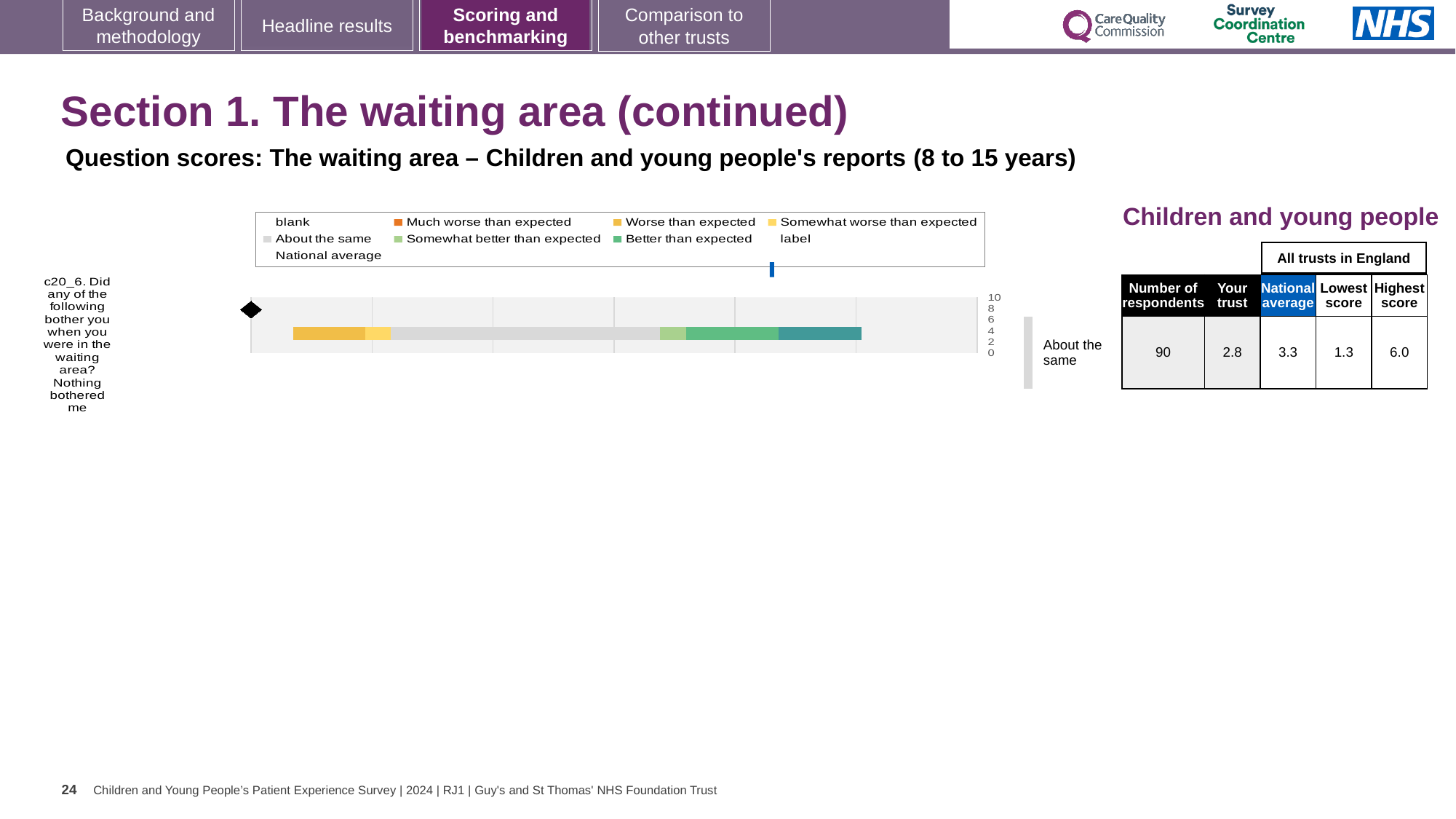
How many respondents answered question c20_6? 90 What kind of chart is shown on the slide? bar chart Which is larger, the 'Your trust' score or the national average? National average What is the difference between the national average and the 'Your trust' score? 0.5 What is the national average score shown in the table? 3.3 What is the highest score across all trusts in England shown in the table? 6.0 Which legend entry is shown with a dark orange colour? Much worse than expected What is the lowest score across all trusts in England shown in the table? 1.3 How many questions (categories) are plotted in the chart? 1 What is the difference between the highest score and the lowest score across all trusts in England? 4.7 What is the benchmark category shown to the right of the bar for question c20_6? About the same What is the 'Your trust' score for question c20_6 in the table? 2.8